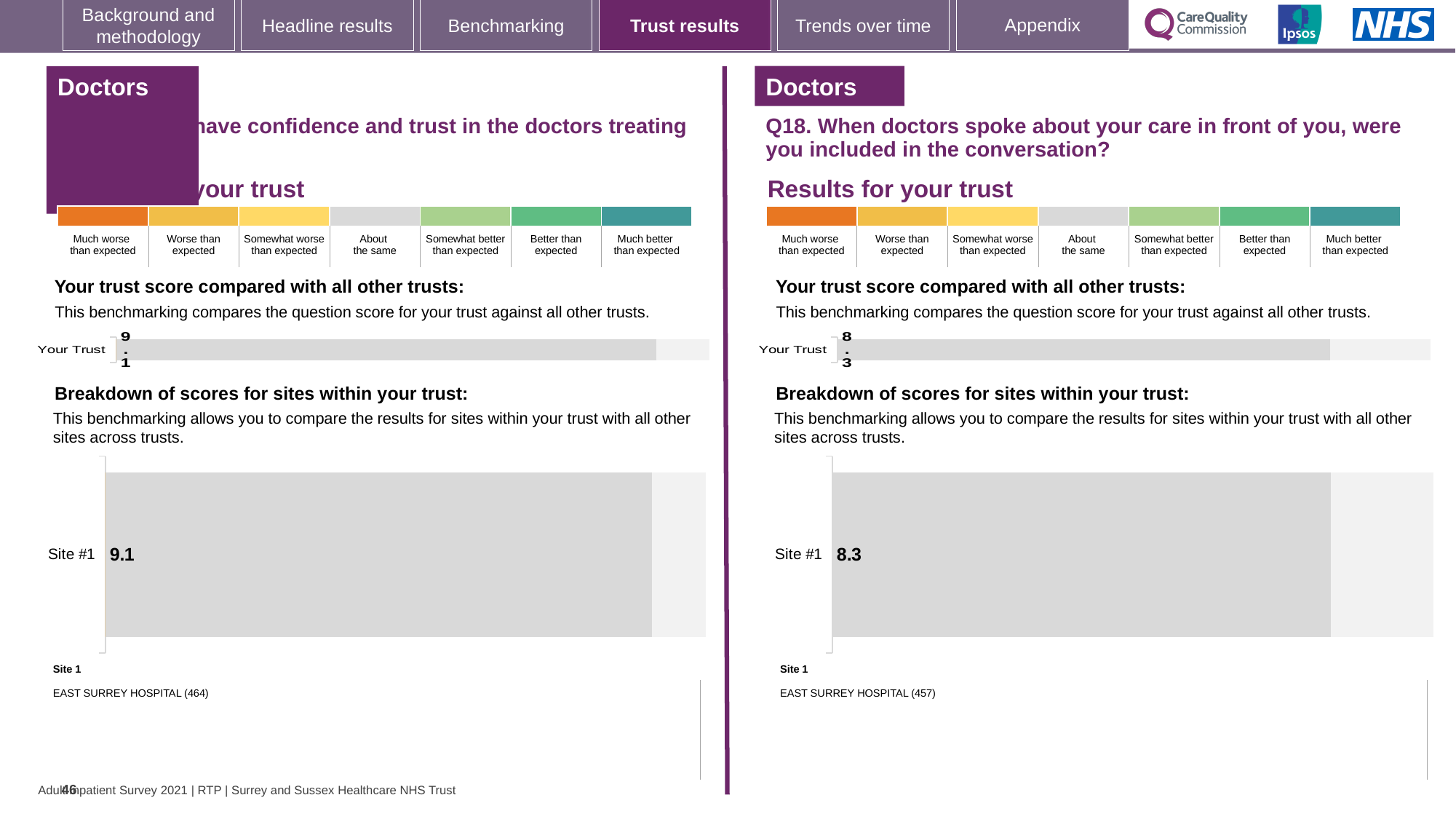
What type of chart is used to show the Your Trust score on the right (Q18) half of the slide? Bar chart What type of chart is used in the left 'Breakdown of scores for sites within your trust' section? Bar chart Which is larger: the Site #1 score in the left breakdown chart or the Site #1 score in the right (Q18) breakdown chart? The left chart (9.1) What is the difference between the Your Trust score on the left half of the slide and the Your Trust score on the right (Q18) half? 0.8 Which hospital is listed as Site 1 under the left breakdown chart? EAST SURREY HOSPITAL (464) Which hospital is listed as Site 1 under the right (Q18) breakdown chart? EAST SURREY HOSPITAL (457) In the left 'Breakdown of scores for sites within your trust' chart, what is the score for Site #1? 9.1 How many sites are shown in the right (Q18) 'Breakdown of scores for sites within your trust' chart? 1 How many sites are shown in the left 'Breakdown of scores for sites within your trust' chart? 1 On the left half of the slide, what is the score shown for Your Trust in the 'Your trust score compared with all other trusts' chart? 9.1 In the right (Q18) 'Breakdown of scores for sites within your trust' chart, what is the score for Site #1? 8.3 On the right half of the slide (Q18), what is the score shown for Your Trust in the 'Your trust score compared with all other trusts' chart? 8.3